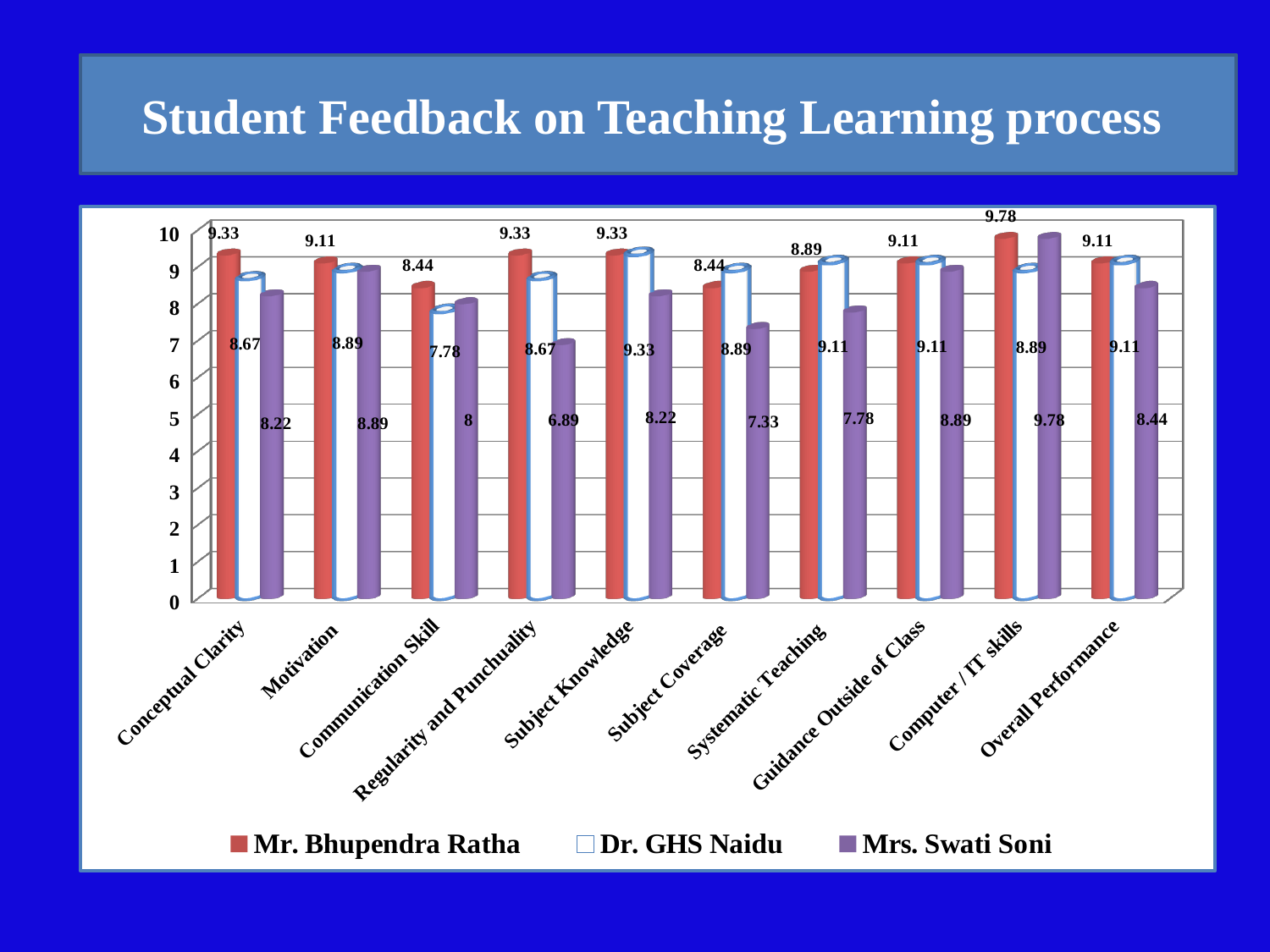
How many series does the legend list? 3 How many categories are shown on the x axis of the chart? 10 What kind of chart is shown on the slide? Bar chart In the Regularity and Punctuality category, what is the difference between Mr. Bhupendra Ratha's value and Mrs. Swati Soni's value? 2.44 What is the value for Dr. GHS Naidu in the Communication Skill category? 7.78 What is the value for Mrs. Swati Soni in the Regularity and Punctuality category? 6.89 In which category does Mr. Bhupendra Ratha have his highest value? Computer / IT skills What is the value for Mrs. Swati Soni in the Computer / IT skills category? 9.78 In the Subject Coverage category, what is the difference between Dr. GHS Naidu's value and Mrs. Swati Soni's value? 1.56 What is the value for Mr. Bhupendra Ratha in the Conceptual Clarity category? 9.33 In the Subject Coverage category, who has the higher value: Mr. Bhupendra Ratha or Dr. GHS Naidu? Dr. GHS Naidu In which category does Mrs. Swati Soni have her lowest value? Regularity and Punctuality